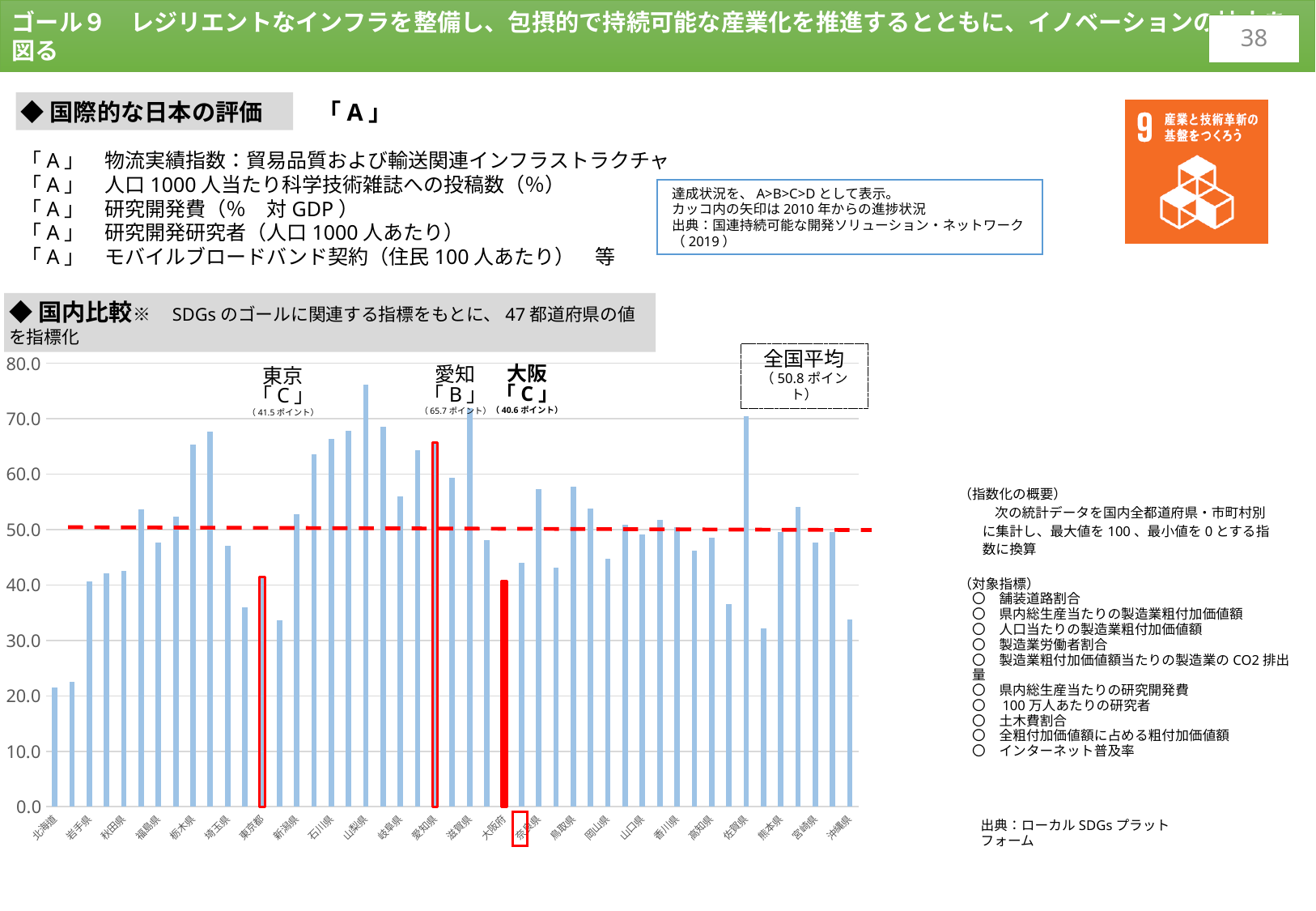
国内比較のグラフで、大阪の値は何ポイントですか？ 40.6 ポイント 国内比較のグラフで、沖縄県の値は40.0より大きいですか、小さいですか？ 小さい 国内比較のグラフは何都道府県の値を指標化していますか？ 47 国内比較のグラフで、東京・愛知・大阪のうち値が最も高いのはどこですか？ 愛知 国内比較のグラフで、東京と大阪ではどちらの値が大きいですか？ 東京 国内比較のグラフで、愛知の値は何ポイントですか？ 65.7 ポイント 国内比較のグラフで、全国平均は何ポイントですか？ 50.8 ポイント 国内比較のグラフはどの種類のグラフですか？ 棒グラフ 国内比較のグラフで、赤い破線は何を示していますか？ 全国平均 国内比較のグラフで、愛知と東京の値の差は何ポイントですか？ 24.2 ポイント 国内比較のグラフで、東京の値は何ポイントですか？ 41.5 ポイント 国内比較のグラフで、北海道の値は30.0より大きいですか、小さいですか？ 小さい